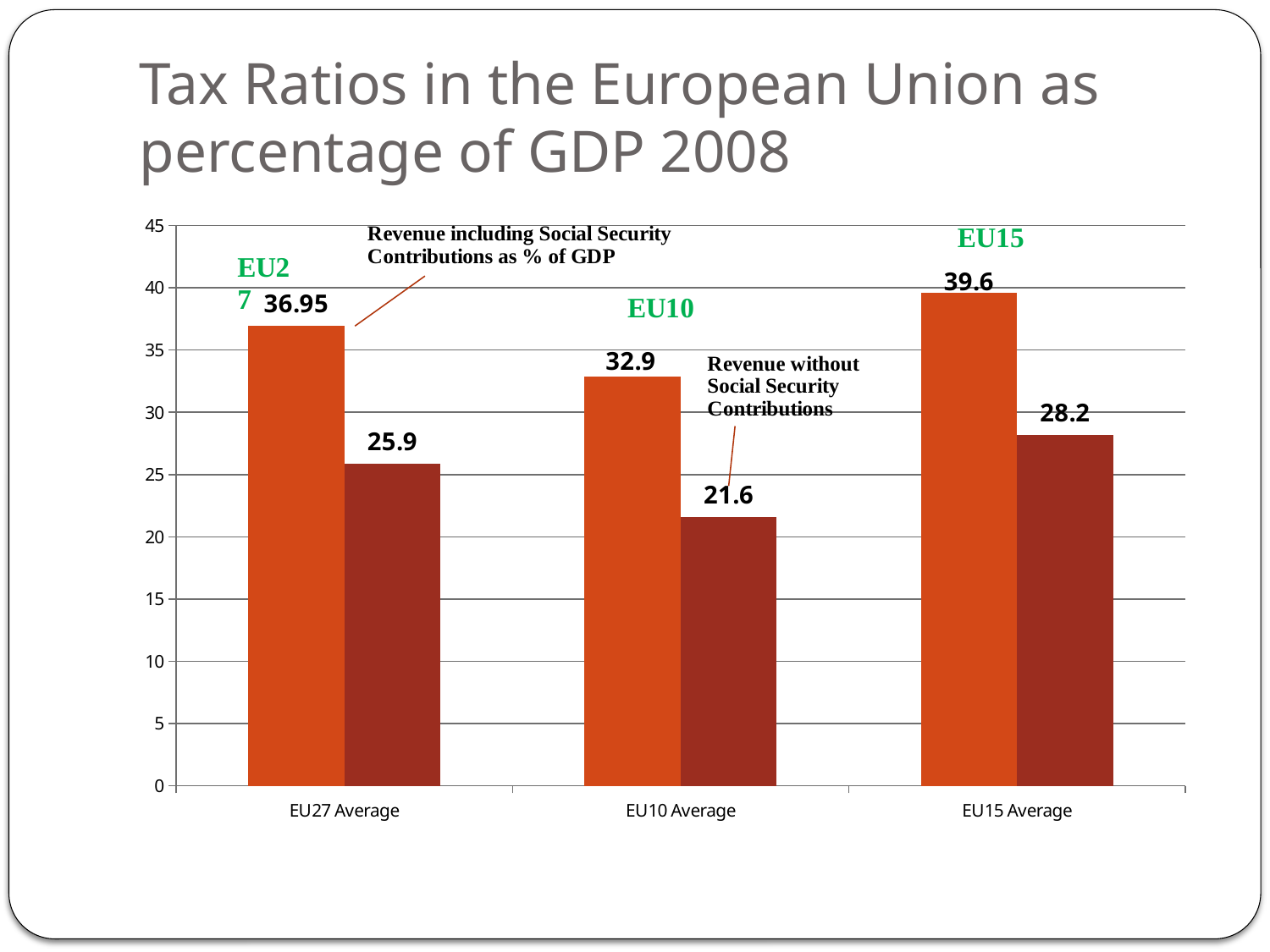
Which category has the lowest value for Revenue without Social Security Contributions? EU10 Average How many data series are plotted in the chart? 2 Which category has the highest value for Revenue including Social Security Contributions as % of GDP? EU15 Average What is the value of Revenue without Social Security Contributions for EU10 Average? 21.6 What is the title of the slide? Tax Ratios in the European Union as percentage of GDP 2008 How many categories are shown on the x axis? 3 Which is larger: Revenue without Social Security Contributions for EU27 Average or for EU15 Average? EU15 Average What is the value of Revenue without Social Security Contributions for EU15 Average? 28.2 What is the difference between Revenue including Social Security Contributions and Revenue without Social Security Contributions for EU10 Average? 11.3 What is the value of Revenue including Social Security Contributions as % of GDP for EU27 Average? 36.95 What is the value of Revenue including Social Security Contributions as % of GDP for EU15 Average? 39.6 What kind of chart is shown on the slide? Bar chart